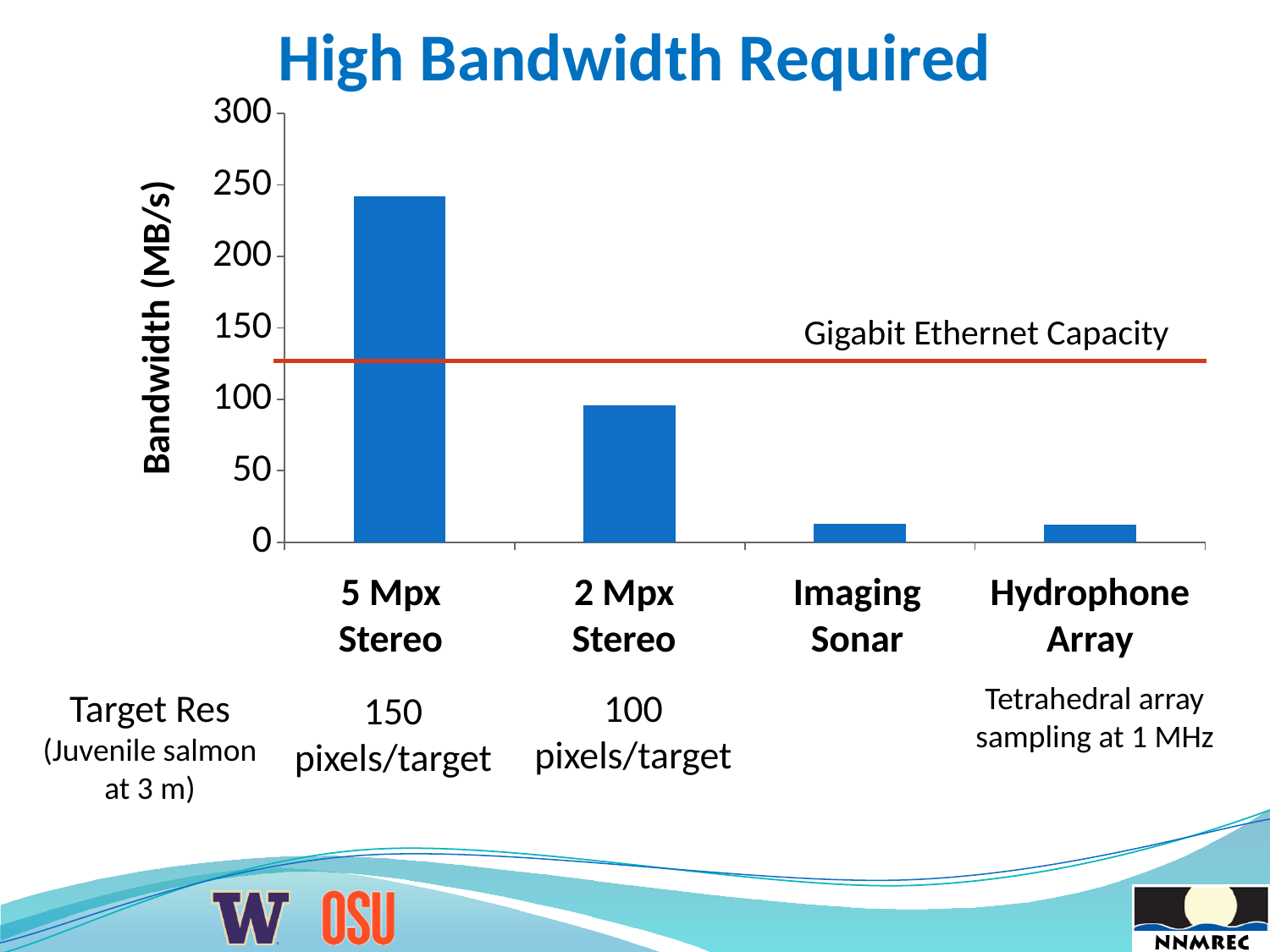
Do the bar values rise or fall moving from left to right along the x axis? fall Is the value for Hydrophone Array greater or less than 50? less Which has a larger bandwidth, 2 Mpx Stereo or Imaging Sonar? 2 Mpx Stereo What is the label of the y axis of the chart? Bandwidth (MB/s) Which has a larger bandwidth, 5 Mpx Stereo or 2 Mpx Stereo? 5 Mpx Stereo Which category has the highest bandwidth in the chart? 5 Mpx Stereo How many categories are plotted on the x axis of the chart? 4 Is the value for Imaging Sonar greater or less than 50? less Is the value for 5 Mpx Stereo greater or less than 200? greater What does the red horizontal line on the chart represent? Gigabit Ethernet Capacity What kind of chart is shown on the slide? bar chart